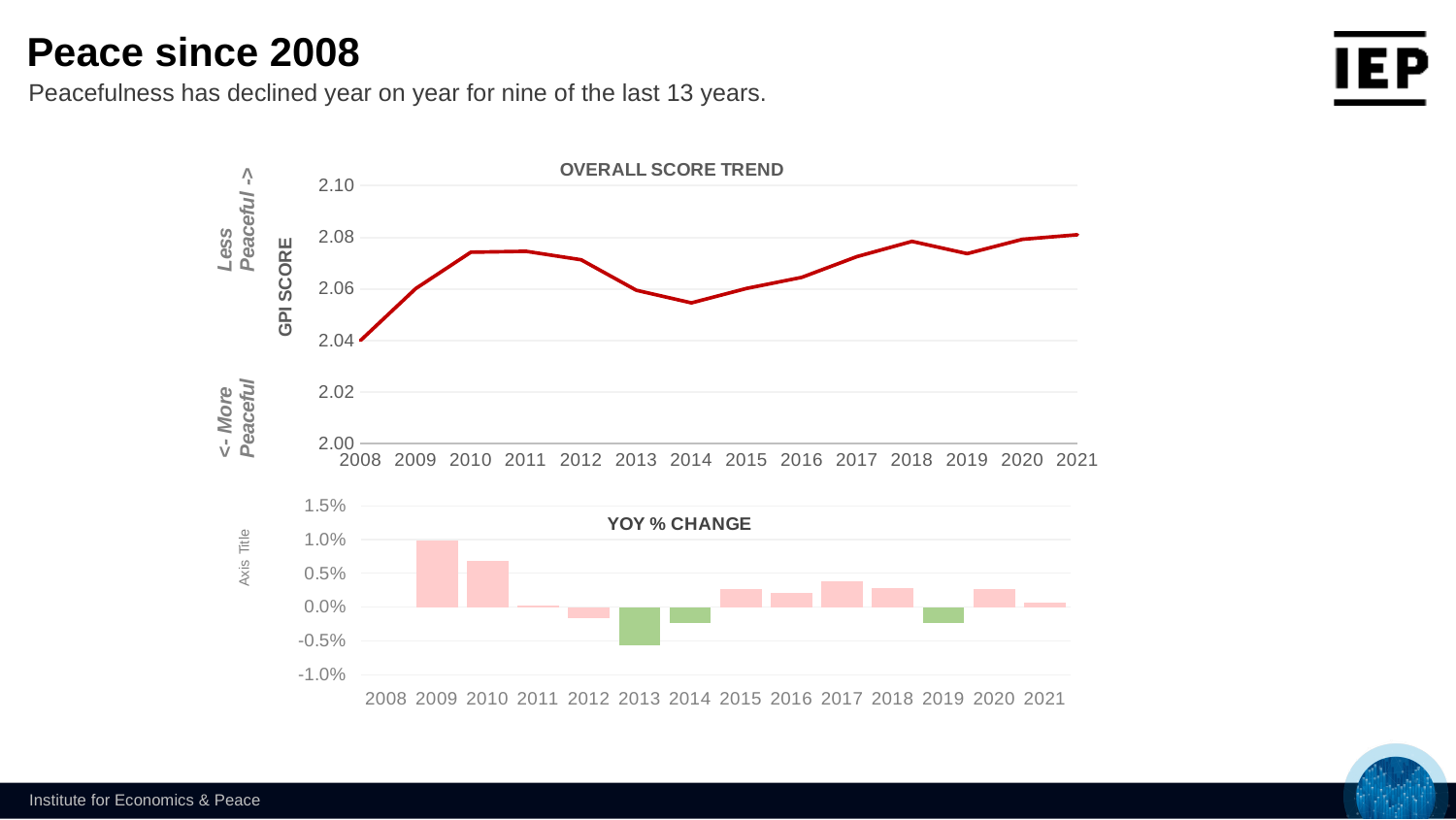
In the YOY % CHANGE chart, which year has the lowest year-on-year change? 2013 In the OVERALL SCORE TREND chart, is the GPI score for 2018 greater or less than 2.06? greater What kind of chart is the OVERALL SCORE TREND chart? line chart In the OVERALL SCORE TREND chart, is the GPI score for 2008 greater or less than 2.06? less In the OVERALL SCORE TREND chart, does the GPI score rise or fall from 2008 to 2010? rise How many years are shown on the x axis of the OVERALL SCORE TREND chart? 14 In the YOY % CHANGE chart, which year has the highest year-on-year change? 2009 In the YOY % CHANGE chart, is the value for 2009 greater or less than 0.5%? greater In the YOY % CHANGE chart, which is larger, the value for 2017 or the value for 2011? 2017 In the OVERALL SCORE TREND chart, which year has the lowest GPI score? 2008 What kind of chart is the YOY % CHANGE chart? bar chart In the OVERALL SCORE TREND chart, does the GPI score rise or fall from 2011 to 2014? fall